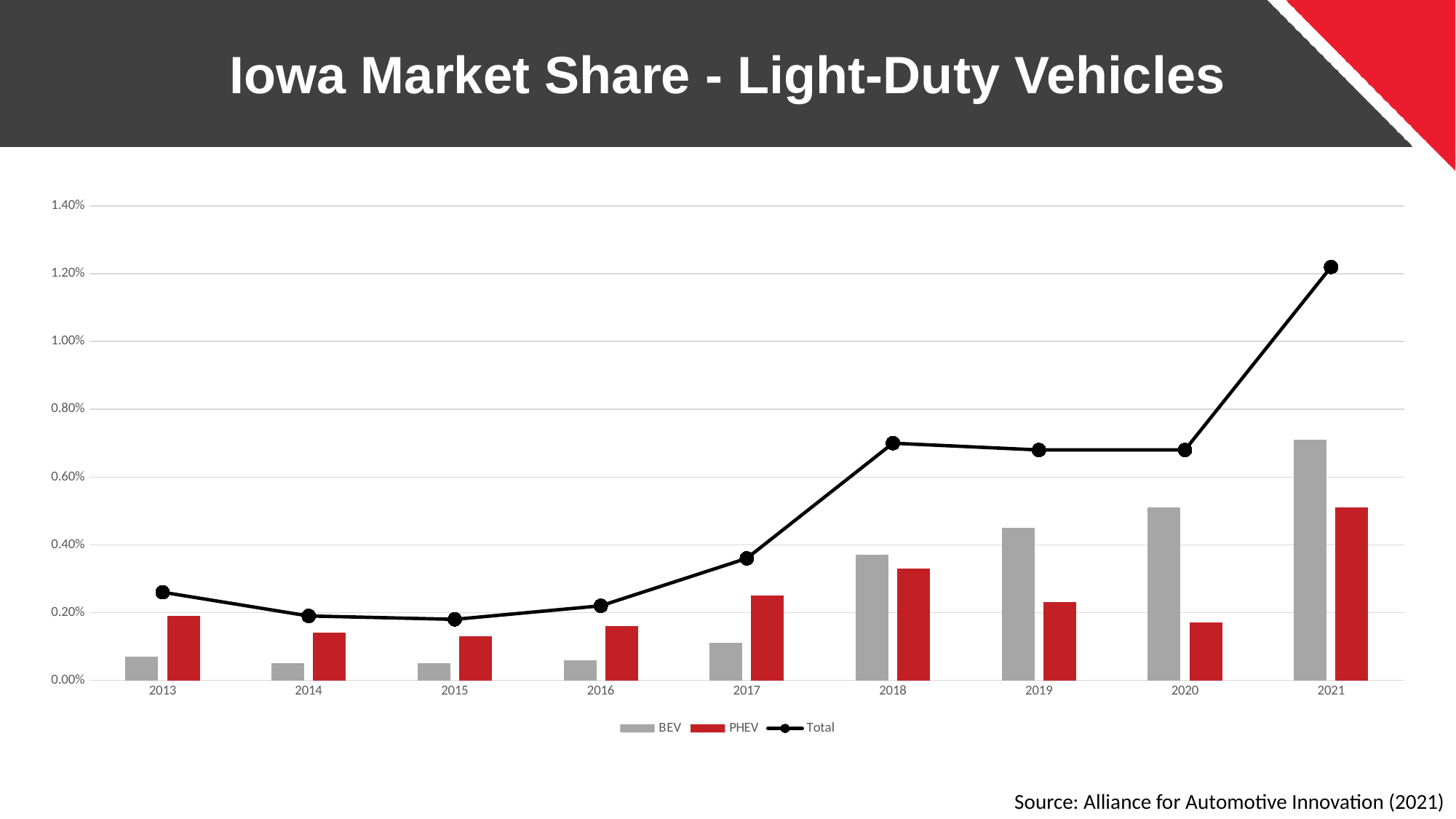
Is the Total value for 2017 greater or less than 0.40%? less In which year is the PHEV bar the tallest? 2021 In which year is the BEV bar the tallest? 2021 In 2019, which is larger, the BEV share or the PHEV share? BEV In 2013, which is larger, the BEV share or the PHEV share? PHEV Is the Total value for 2021 greater or less than 1.00%? greater How many series does the legend list? 3 Is the BEV value for 2021 greater or less than 0.60%? greater What kind of chart is shown on the slide? A combined bar and line chart In which year is the Total market share highest? 2021 How many years are shown on the x axis? 9 Does the BEV share rise or fall from 2016 to 2021? Rise